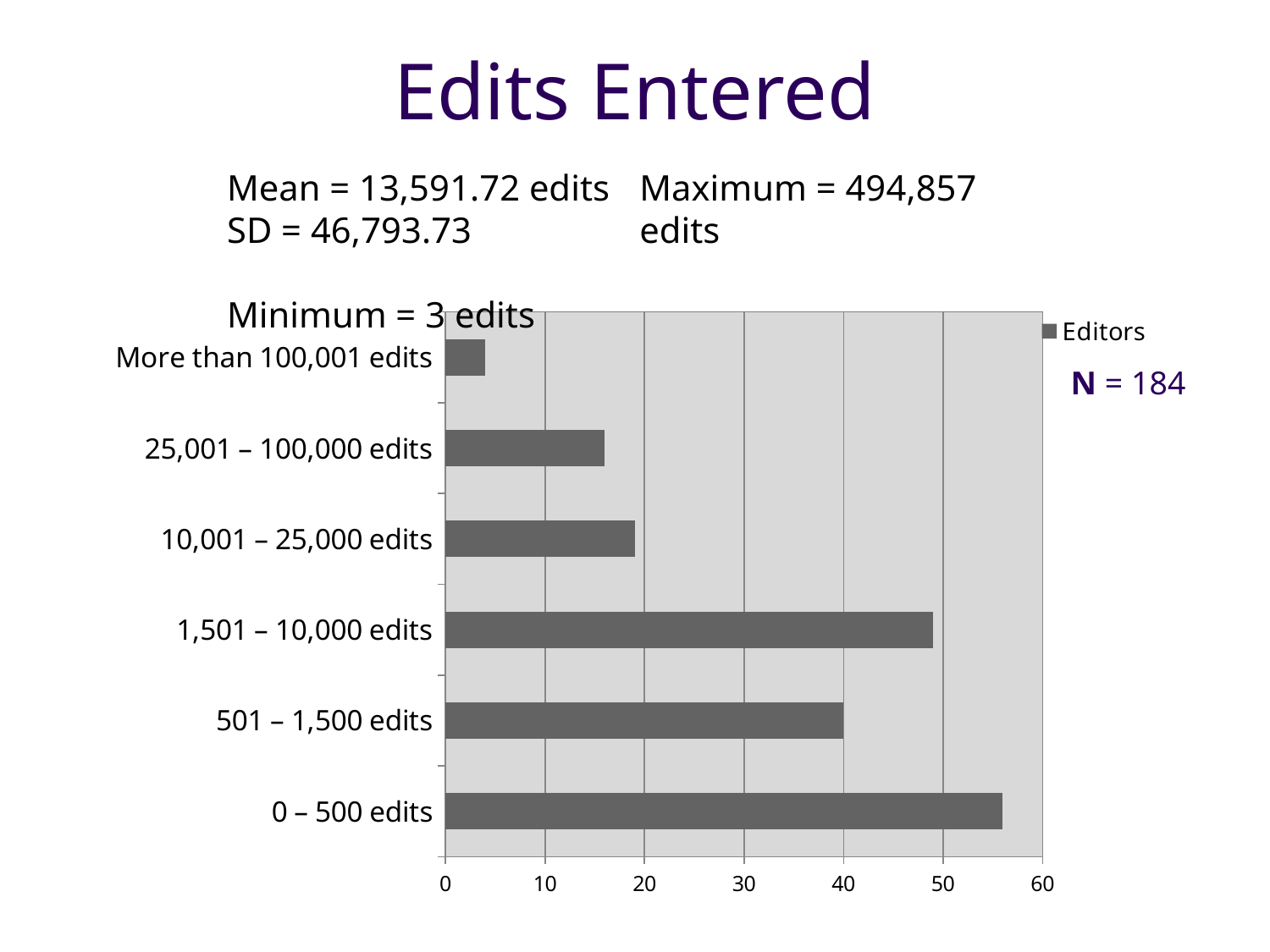
Is the value for 0 – 500 edits greater or less than 50? greater How many categories of edit counts are plotted in the chart? 6 What is the name of the series shown in the chart legend? Editors Which has more editors: 1,501 – 10,000 edits or 501 – 1,500 edits? 1,501 – 10,000 edits Is the value for 25,001 – 100,000 edits greater or less than 20? less Which category has the highest number of editors? 0 – 500 edits Is the value for More than 100,001 edits greater or less than 10? less How many series does the chart legend list? 1 What kind of chart is shown on the slide? bar chart Which has more editors: 10,001 – 25,000 edits or More than 100,001 edits? 10,001 – 25,000 edits Which category has the lowest number of editors? More than 100,001 edits